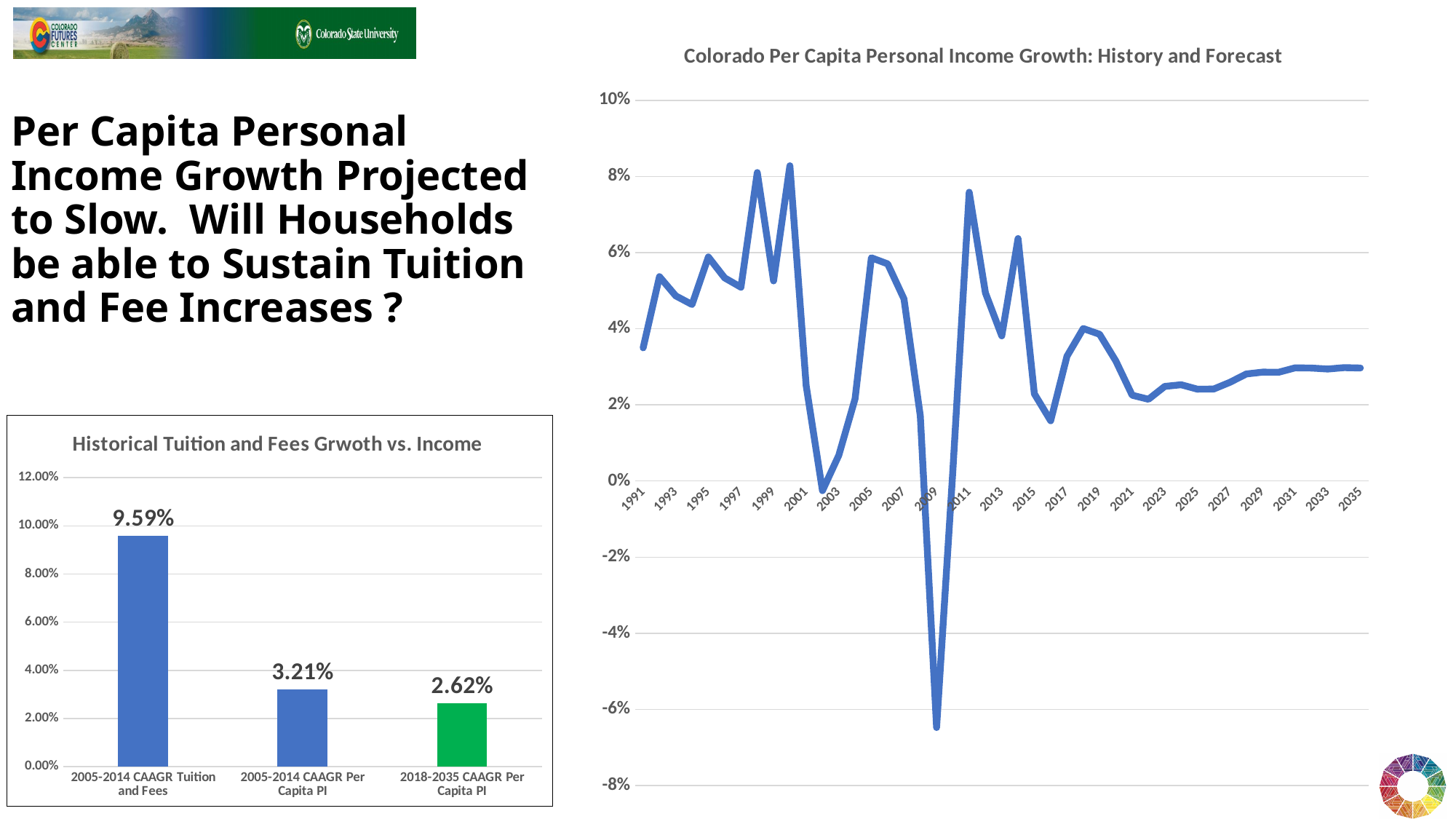
In the 'Historical Tuition and Fees Grwoth vs. Income' chart, what is the difference between 2005-2014 CAAGR Tuition and Fees and 2005-2014 CAAGR Per Capita PI? 6.38% In the 'Historical Tuition and Fees Grwoth vs. Income' chart, how many bars are shown? 3 What kind of chart is 'Historical Tuition and Fees Grwoth vs. Income'? Bar chart In the 'Historical Tuition and Fees Grwoth vs. Income' chart, which category has the lowest value? 2018-2035 CAAGR Per Capita PI In the 'Colorado Per Capita Personal Income Growth: History and Forecast' chart, is the value for 2035 greater or less than 2%? greater What kind of chart is 'Colorado Per Capita Personal Income Growth: History and Forecast'? Line chart In the 'Historical Tuition and Fees Grwoth vs. Income' chart, which bar is shown in green? 2018-2035 CAAGR Per Capita PI In the 'Historical Tuition and Fees Grwoth vs. Income' chart, what is the value for 2018-2035 CAAGR Per Capita PI? 2.62% In the 'Colorado Per Capita Personal Income Growth: History and Forecast' chart, is the value for 2009 greater or less than -4%? less In the 'Historical Tuition and Fees Grwoth vs. Income' chart, what is the value for 2005-2014 CAAGR Per Capita PI? 3.21% In the 'Historical Tuition and Fees Grwoth vs. Income' chart, which category has the highest value? 2005-2014 CAAGR Tuition and Fees In the 'Historical Tuition and Fees Grwoth vs. Income' chart, what is the value for 2005-2014 CAAGR Tuition and Fees? 9.59%